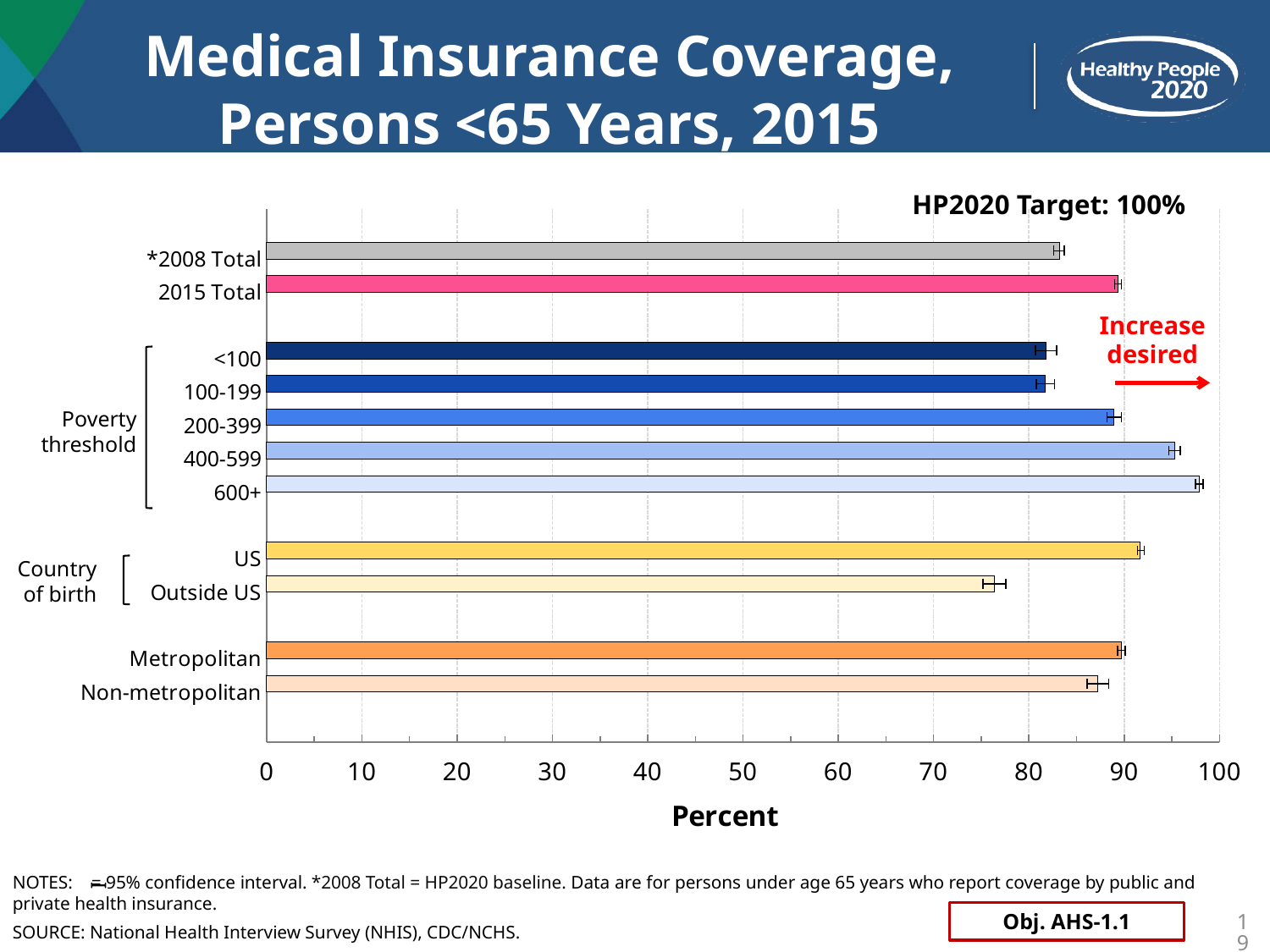
Is the value for 400-599 greater or less than 90? greater How many bars are plotted in the chart? 11 Is the value for 600+ greater or less than 90? greater Across the poverty threshold groups from <100 to 600+, do the values rise or fall? rise What kind of chart is shown on the slide? bar chart Which is larger, the value for 2015 Total or the value for *2008 Total? 2015 Total Which category has the lowest medical insurance coverage? Outside US Is the value for *2008 Total greater or less than 80? greater Which category has the highest medical insurance coverage? 600+ What is the HP2020 target shown on the chart? 100% Which is larger, the value for US or the value for Outside US? US